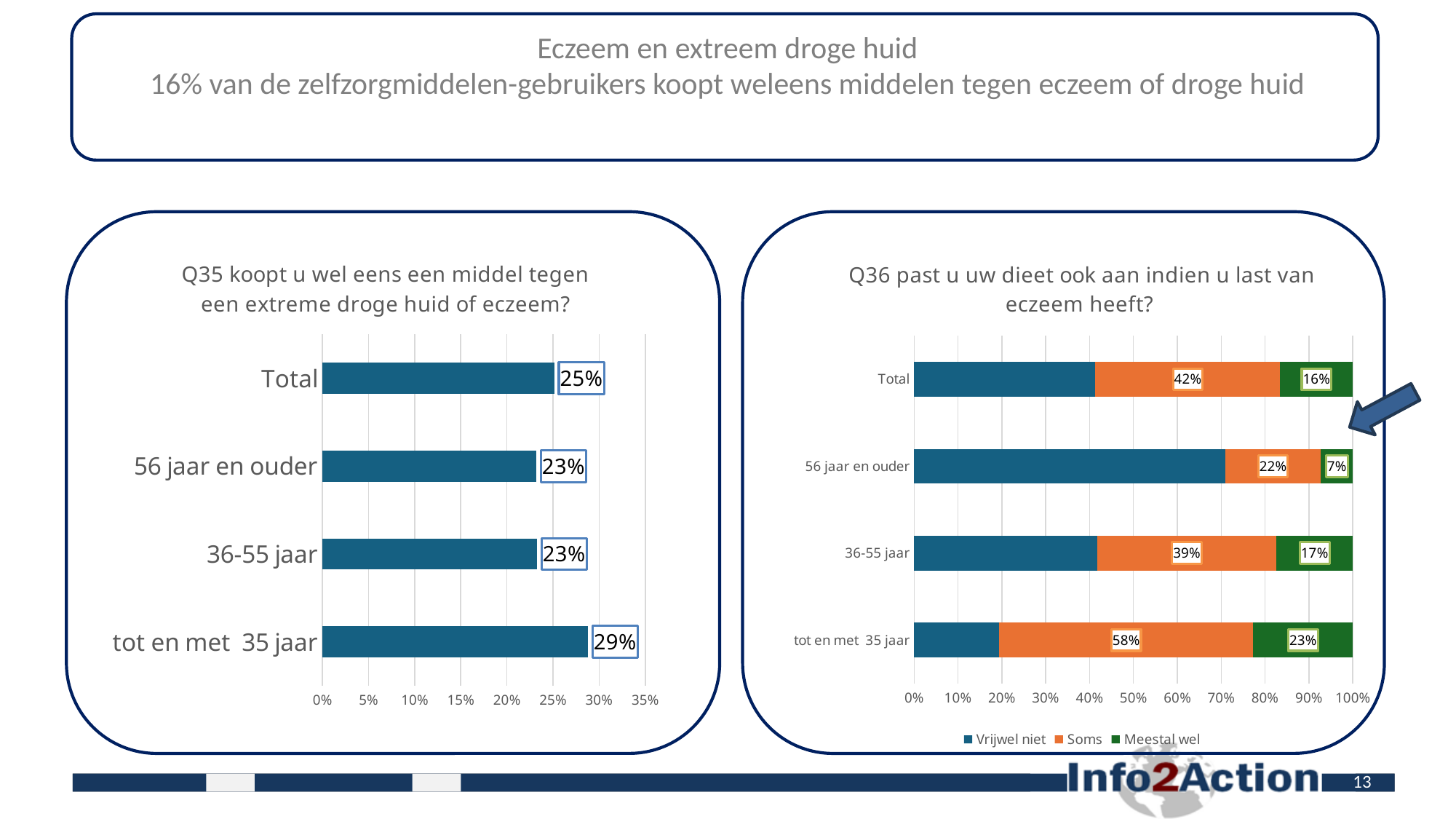
In the Q35 chart, what is the difference between the values for 'tot en met 35 jaar' and '56 jaar en ouder'? 6% In the Q35 chart, what is the value for 'tot en met 35 jaar'? 29% In the Q35 chart, which category has the highest value? tot en met 35 jaar In the Q36 chart, what is the 'Meestal wel' value for '56 jaar en ouder'? 7% How many series does the legend of the Q36 chart list? 3 In the Q36 chart, which category has the lowest 'Meestal wel' value? 56 jaar en ouder In the Q36 chart, what is the 'Soms' value for 'tot en met 35 jaar'? 58% In the Q36 chart, is the 'Soms' value for 'Total' larger or smaller than the 'Soms' value for '36-55 jaar'? larger What kind of chart is the Q36 chart? stacked bar chart In the Q36 chart, is the 'Vrijwel niet' value for '56 jaar en ouder' greater or less than 60%? greater In the Q35 chart, what is the value for 'Total'? 25% In the Q35 chart, how many categories are shown? 4